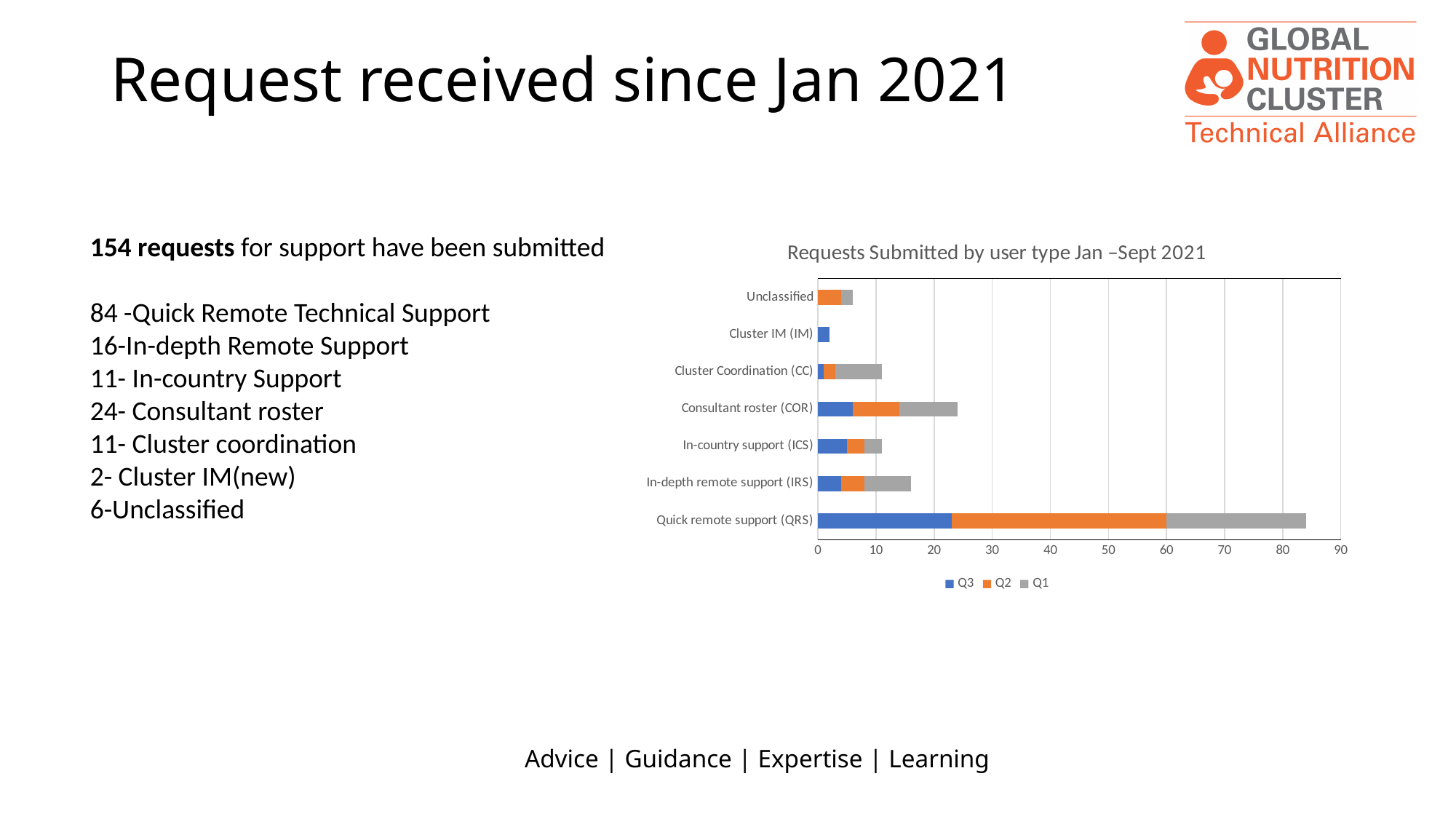
Which has the longer total bar, Consultant roster (COR) or In-depth remote support (IRS)? Consultant roster (COR) How many series does the chart legend list? 3 Which series are listed in the chart legend? Q3, Q2, Q1 Which user type has the longest total bar in the chart? Quick remote support (QRS) What kind of chart is shown on the slide? Stacked bar chart What is the title of the chart? Requests Submitted by user type Jan –Sept 2021 Which user type has the shortest total bar in the chart? Cluster IM (IM) Is the total bar for Consultant roster (COR) greater or less than 20? greater Is the total bar for Quick remote support (QRS) greater or less than 70? greater Is the total bar for Cluster IM (IM) greater or less than 10? less Which has the longer total bar, Unclassified or Cluster IM (IM)? Unclassified How many user type categories are plotted in the chart? 7